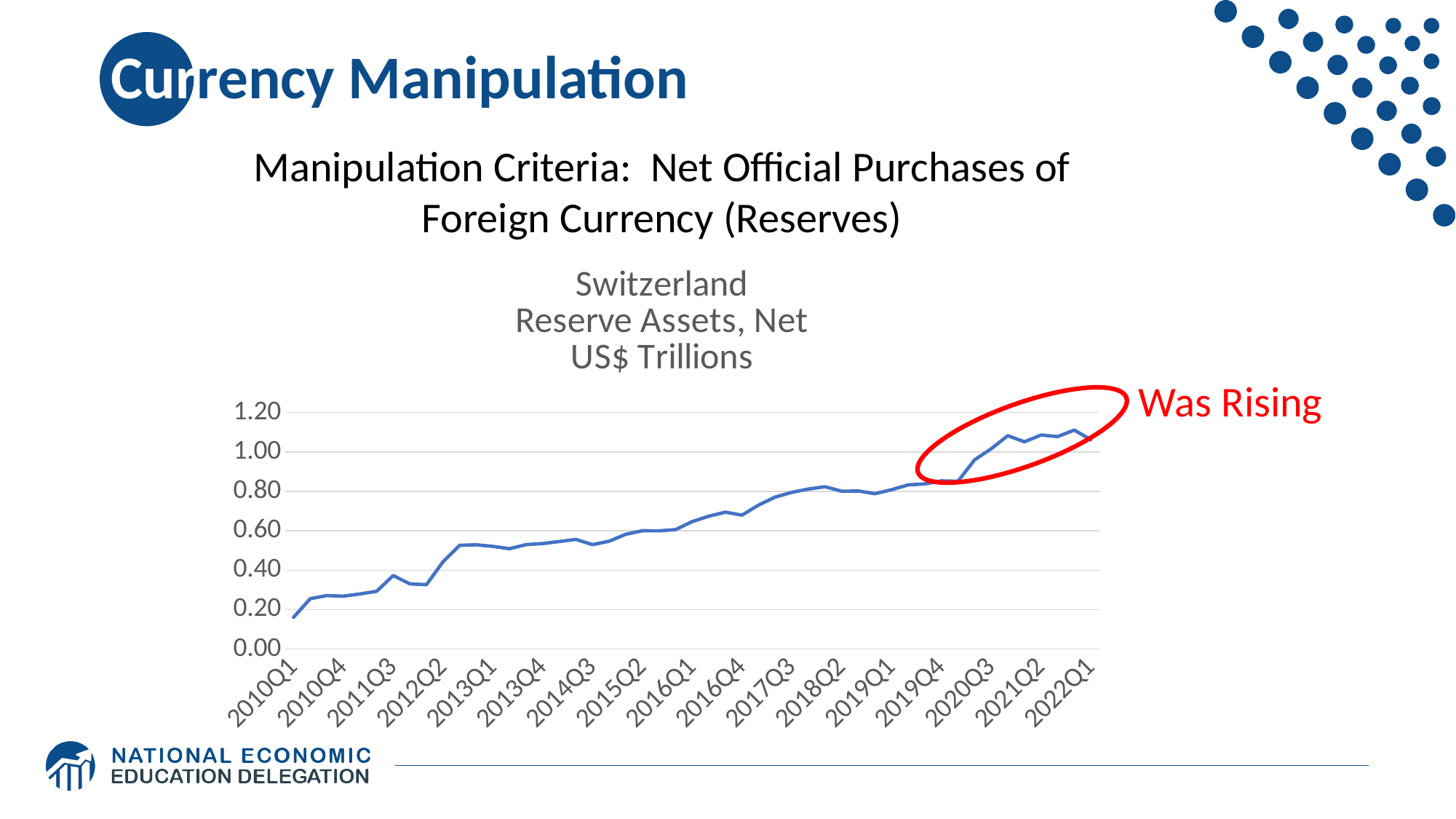
How many quarter labels are shown on the x axis? 17 Is the value for 2013Q1 greater or less than 0.40? greater Which quarter has the lowest value on the chart? 2010Q1 Which is larger, the value for 2022Q1 or the value for 2010Q1? 2022Q1 Overall, do the values rise or fall from 2010Q1 to 2022Q1? Rise Is the value for 2011Q3 greater or less than 0.40? less Is the value for 2010Q1 greater or less than 0.20? less What kind of chart is shown on the slide? Line chart Which country's reserve assets does the chart show? Switzerland What does the red annotation next to the circled part of the line say? Was Rising